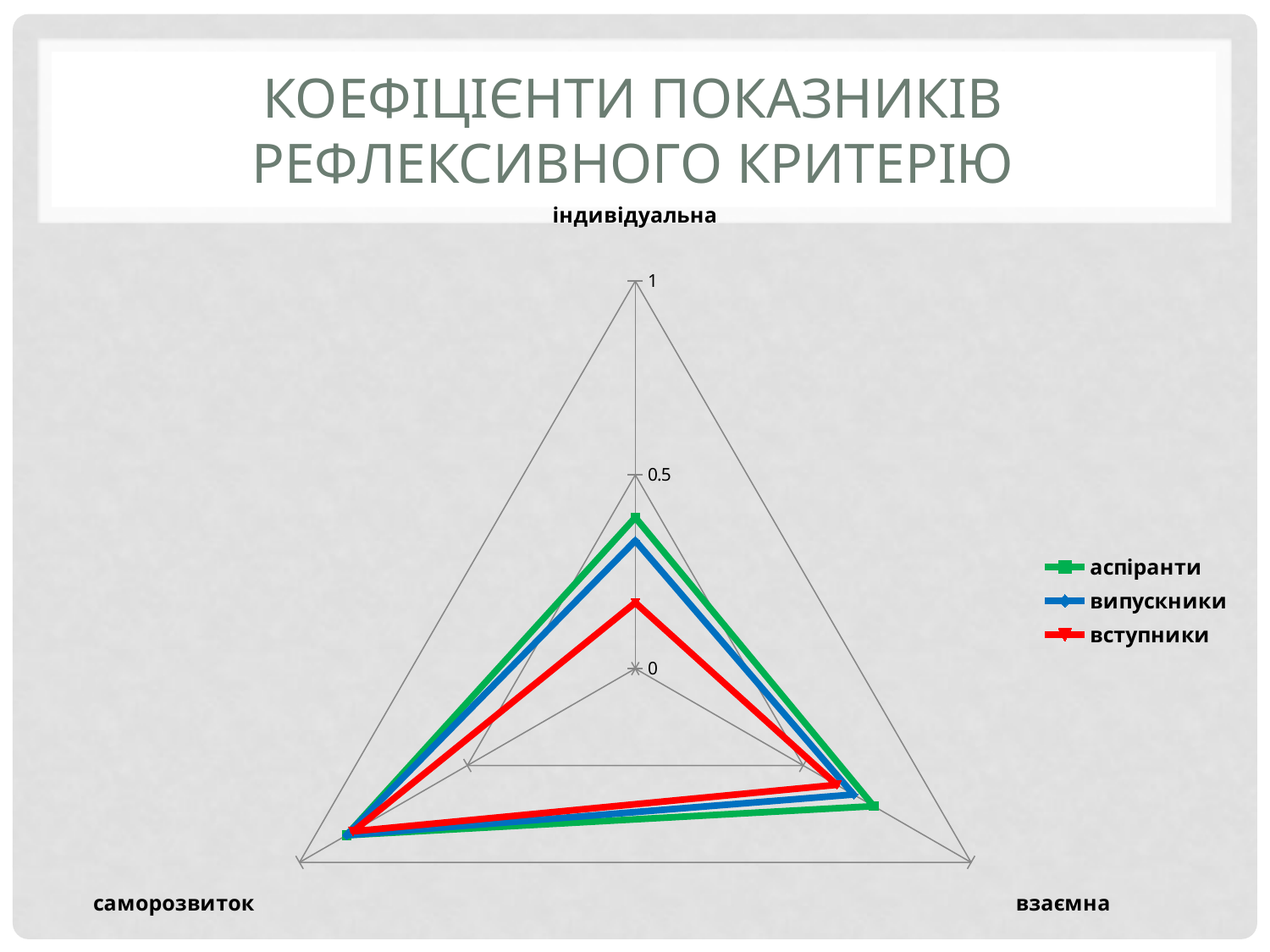
How many axes (categories) does the radar chart have? 3 Is the value for аспіранти on the саморозвиток axis greater or less than 0.5? greater What colour is the line for the вступники series? red Is the value for вступники on the індивідуальна axis greater or less than 0.5? less Which series has the highest value on the індивідуальна axis? аспіранти How many series does the legend list? 3 On which axis does the аспіранти series reach its highest value? саморозвиток Which series has the lowest value on the індивідуальна axis? вступники On the індивідуальна axis, which is larger: the value for аспіранти or for вступники? аспіранти What kind of chart is shown on the slide? radar chart Is the value for аспіранти on the взаємна axis greater or less than 0.5? greater